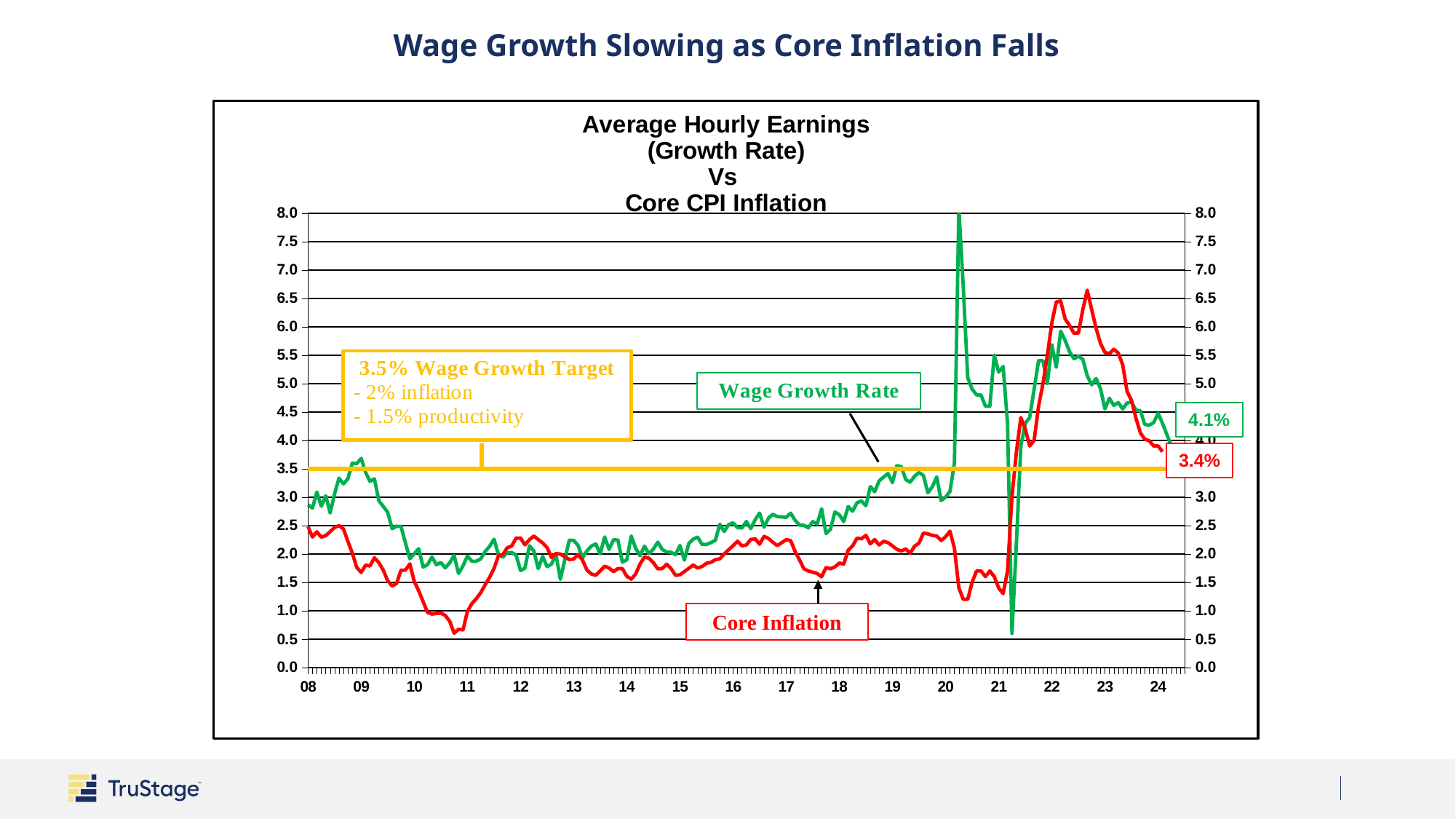
How many data series are plotted on the chart? 3 Is the peak of the Wage Growth Rate line around 2020 greater or less than 7.0? greater What is the most recent value labelled for the Core Inflation line? 3.4% Is the peak of the Core Inflation line around 2022 greater or less than 6.0? greater How does the Wage Growth Rate line move from 2022 to 2024? It falls What kind of chart is shown on the slide? Line chart At the latest labelled point, which is larger: the Wage Growth Rate or Core Inflation? Wage Growth Rate What colour is the Core Inflation line? Red What is the difference between the latest labelled Wage Growth Rate (4.1%) and the latest labelled Core Inflation (3.4%)? 0.7% What is the most recent value labelled for the Wage Growth Rate line? 4.1% Is the lowest point of the Core Inflation line around 2011 greater or less than 1.0? less What wage growth target is marked by the horizontal yellow line? 3.5%